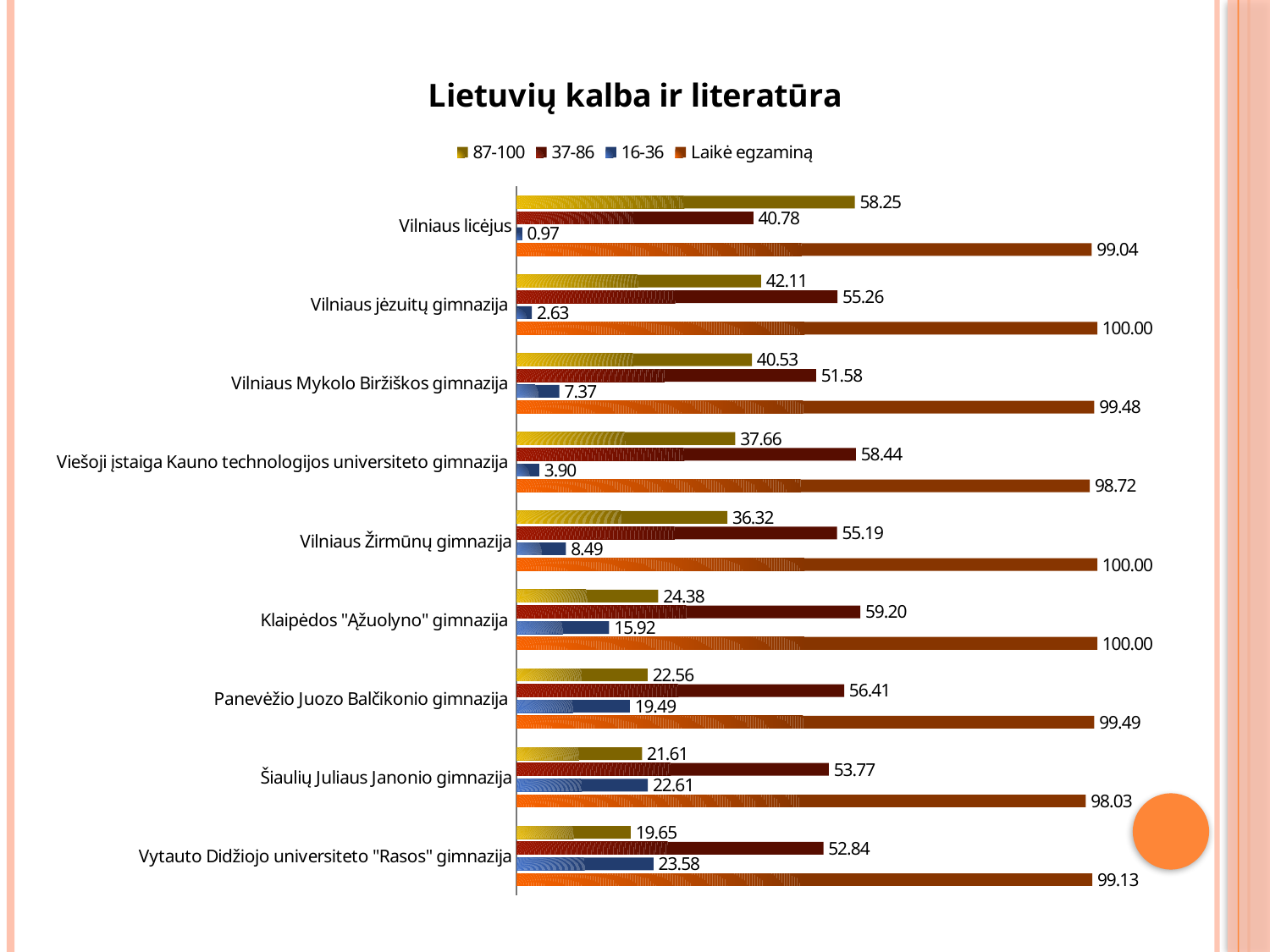
Which school has the lowest value in the 16-36 series? Vilniaus licėjus What is the difference between the 87-100 values of Vilniaus licėjus and Vilniaus jėzuitų gimnazija? 16.14 What is the value of the 16-36 series for Vytauto Didžiojo universiteto "Rasos" gimnazija? 23.58 What is the value of the 87-100 series for Vilniaus licėjus? 58.25 Which school has the highest value in the 87-100 series? Vilniaus licėjus What kind of chart is shown on the slide? Bar chart Which is larger: the 37-86 value for Vilniaus Žirmūnų gimnazija or for Panevėžio Juozo Balčikonio gimnazija? Panevėžio Juozo Balčikonio gimnazija How many schools are shown on the chart? 9 What is the Laikė egzaminą value for Šiaulių Juliaus Janonio gimnazija? 98.03 What is the title of the chart? Lietuvių kalba ir literatūra What is the 37-86 value for Klaipėdos "Ąžuolyno" gimnazija? 59.20 How many series does the legend list? 4